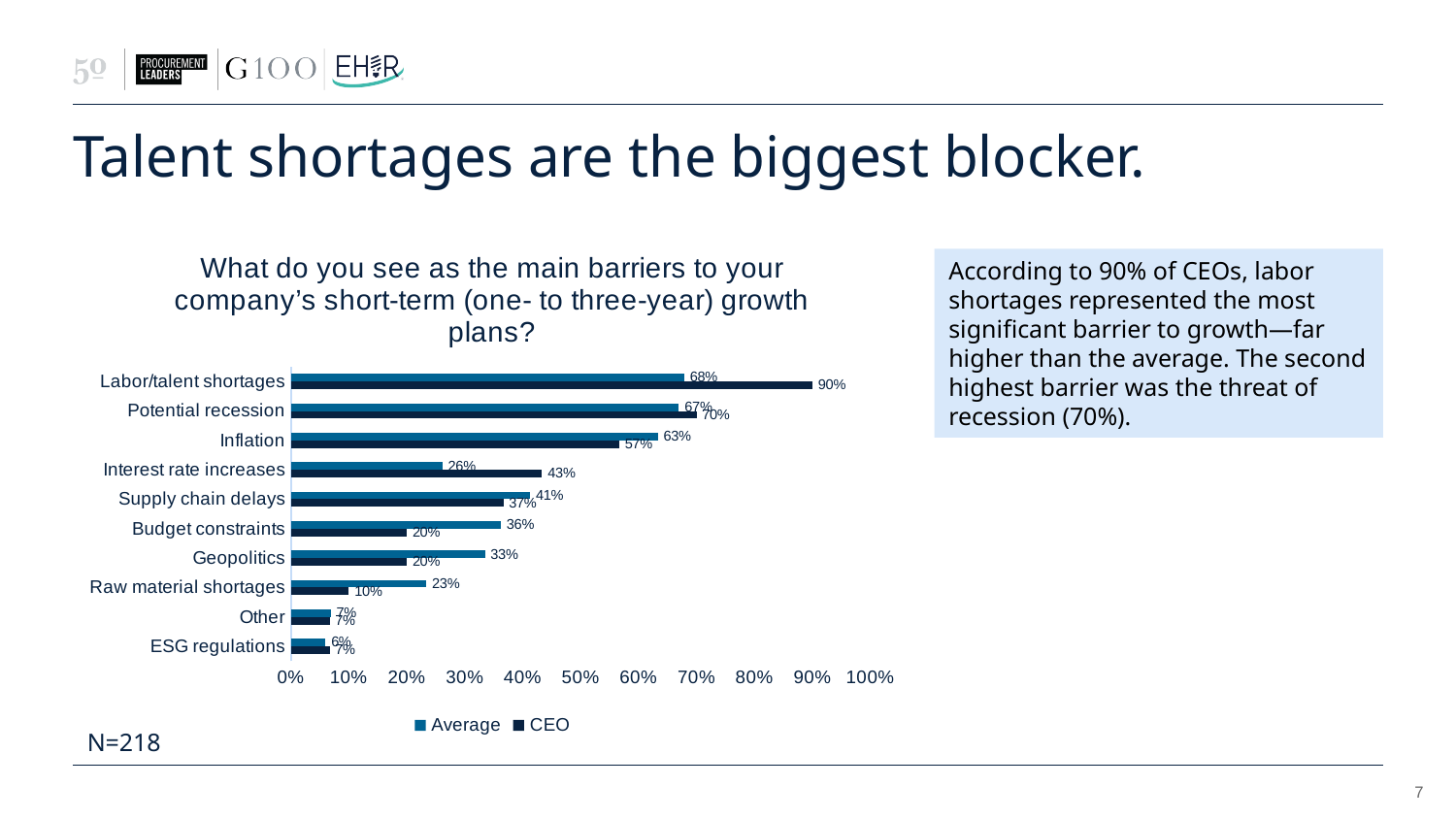
How many categories are shown on the chart? 10 What is the CEO value for Interest rate increases? 43% Which category has the lowest Average value? ESG regulations What is the difference between the CEO and Average values for Labor/talent shortages? 22% What is the CEO value for Labor/talent shortages? 90% What kind of chart is shown on the slide? Bar chart How many series does the legend list? 2 Which is larger for Budget constraints, the Average value or the CEO value? Average What is the Average value for Raw material shortages? 23% What is the Average value for Inflation? 63% Which category has the highest CEO value? Labor/talent shortages Is the CEO value for Supply chain delays greater or less than 30%? greater